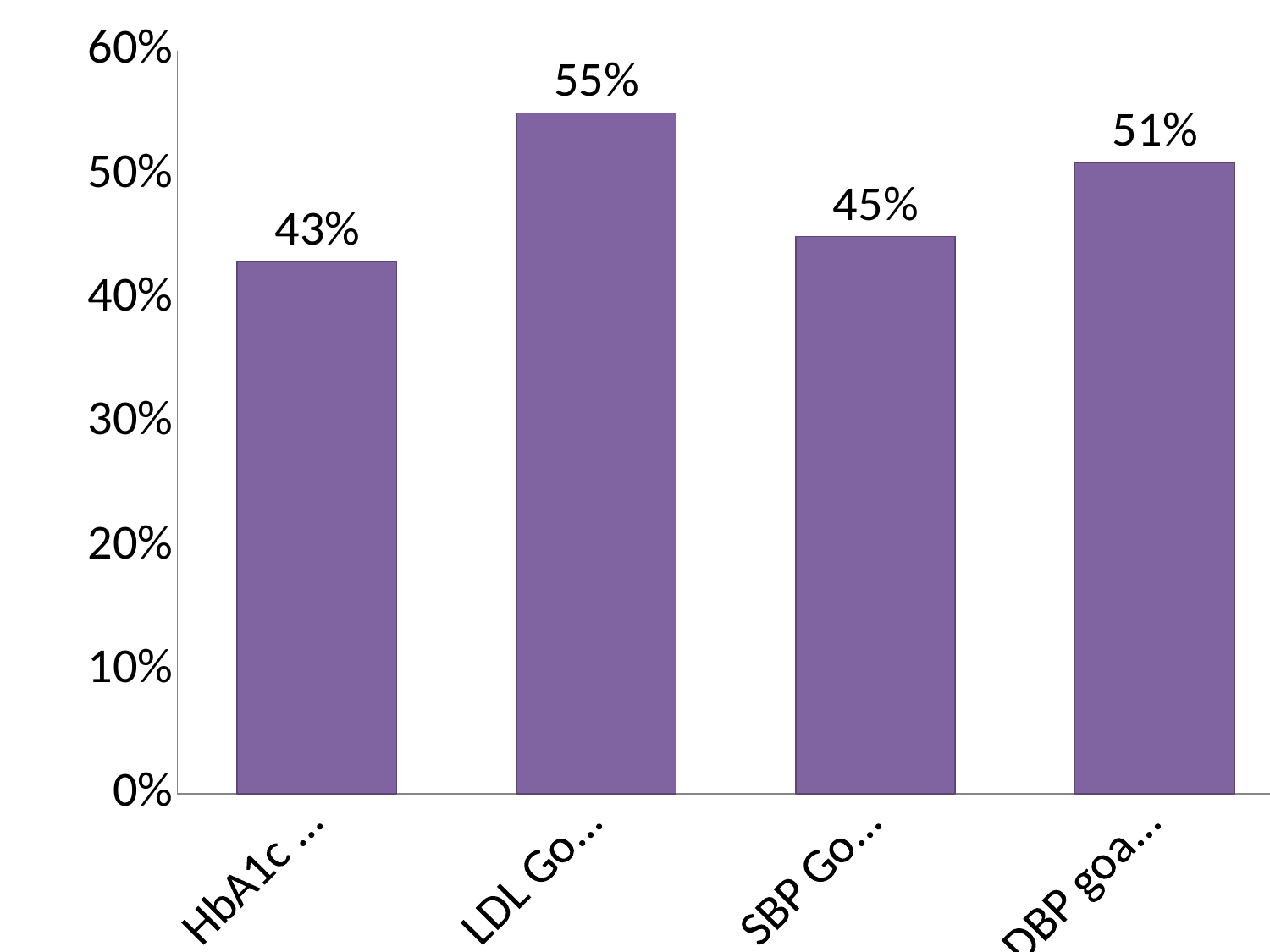
What value is shown for the LDL bar? 55% How many bars are shown in the chart? 4 Which bar has the lowest value? HbA1c Which is larger, the SBP value or the DBP value? DBP What value is shown for the SBP bar? 45% What value is shown for the HbA1c bar? 43% What value is shown for the DBP bar? 51% What is the difference between the LDL value and the HbA1c value? 12% Is the value for the LDL bar greater or less than 50%? greater What kind of chart is shown on the slide? bar chart Which bar has the highest value? LDL What is the difference between the DBP value and the SBP value? 6%